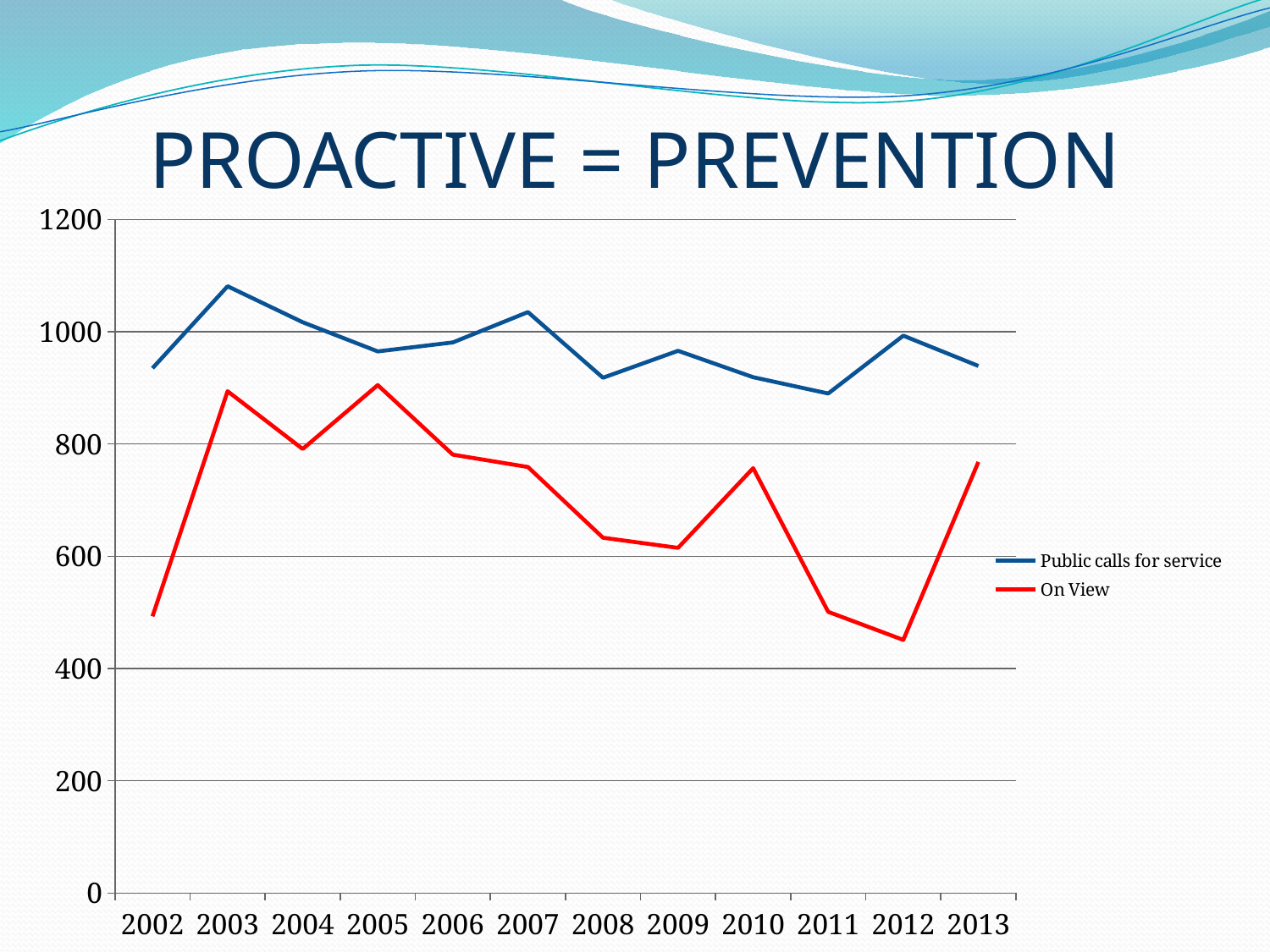
How many series does the legend list? 2 Is the On View value for 2013 greater or less than 600? greater Is the Public calls for service value for 2003 greater or less than 1000? greater In which year is the Public calls for service series at its highest? 2003 In 2002, which series has the larger value, Public calls for service or On View? Public calls for service What is the title of the slide containing the chart? PROACTIVE = PREVENTION Does the On View series rise or fall from 2010 to 2012? fall In which year is the On View series at its lowest? 2012 How many years are plotted along the x axis? 12 Is the On View value for 2002 greater or less than 600? less What kind of chart is shown on the slide? line chart Which series is drawn in red? On View